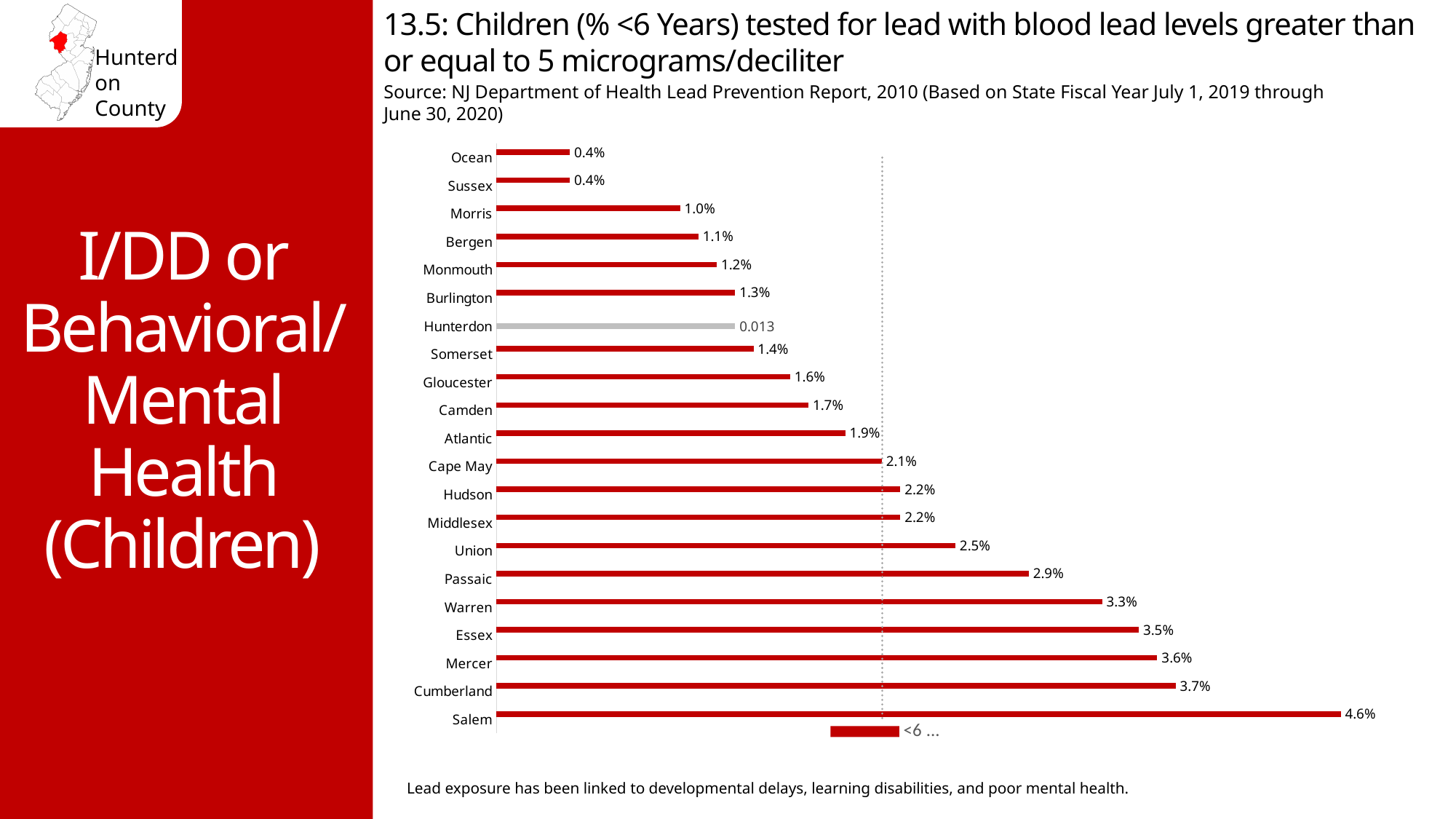
Which county has the lowest value, Ocean or Morris? Ocean What kind of chart is shown on the slide? Bar chart What is the data label shown for Hunterdon? 0.013 What is the difference between the values for Cumberland and Mercer? 0.1% What is the value for Morris? 1.0% What is the value for Salem? 4.6% Which county has the highest value? Salem What is the difference between the values for Salem and Ocean? 4.2% How many counties are shown in the chart? 21 Which is larger, the value for Passaic or the value for Union? Passaic Which county's bar is coloured grey instead of red? Hunterdon